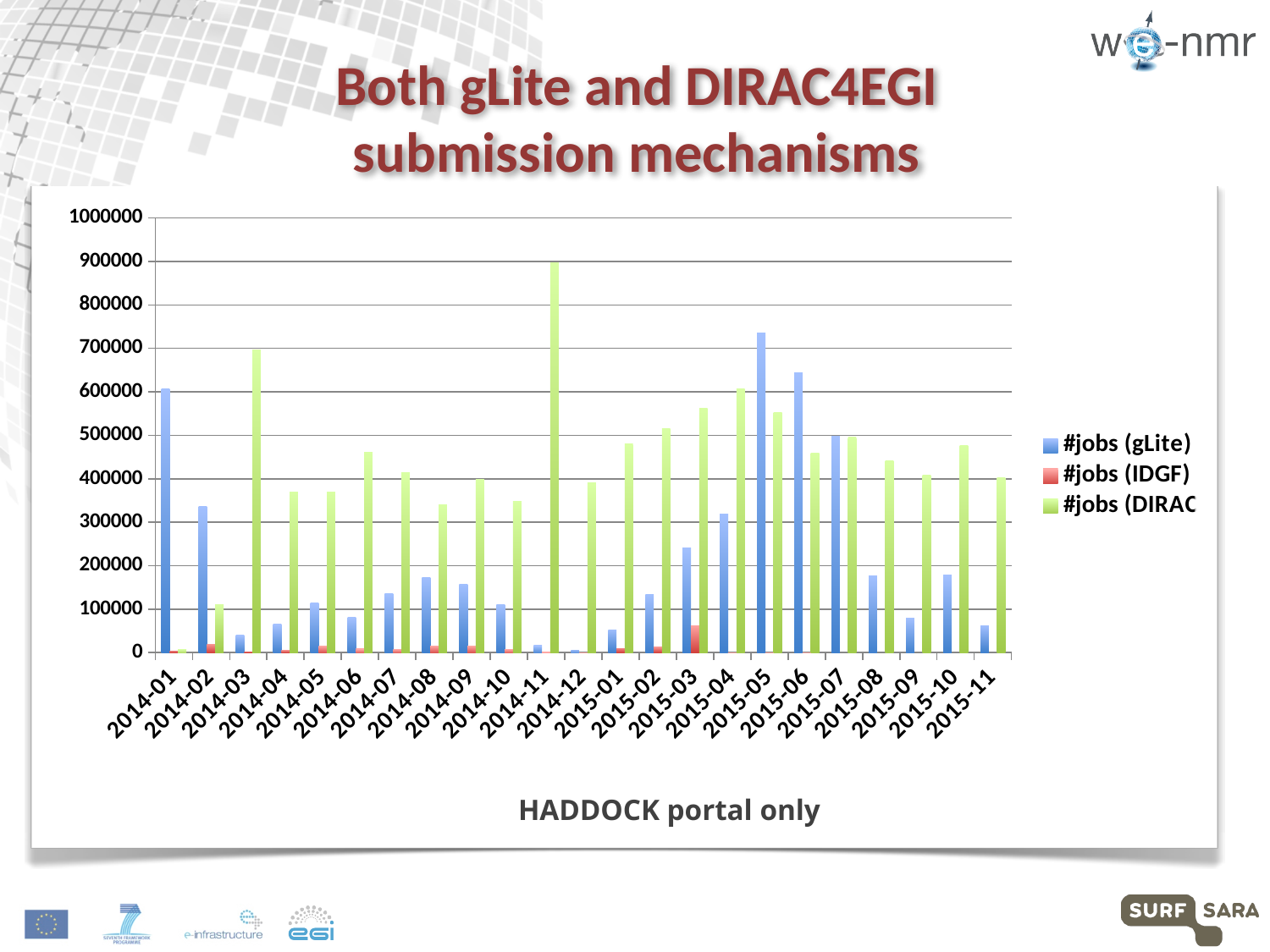
Is the #jobs (gLite) value for 2014-11 greater or less than 100000? less Is the #jobs (gLite) value for 2014-01 greater or less than 500000? greater For 2015-05, which is larger: #jobs (gLite) or #jobs (DIRAC)? #jobs (gLite) For 2014-03, which is larger: #jobs (gLite) or #jobs (DIRAC)? #jobs (DIRAC) How many months (categories) are shown on the x axis? 23 What kind of chart is shown on the slide? bar chart Is the #jobs (DIRAC) value for 2014-11 greater or less than 800000? greater In which month is the #jobs (gLite) value highest? 2015-05 What colour are the #jobs (IDGF) bars? red In which month is the #jobs (DIRAC) value highest? 2014-11 How many series does the legend list? 3 In which month is the #jobs (DIRAC) value lowest? 2014-01